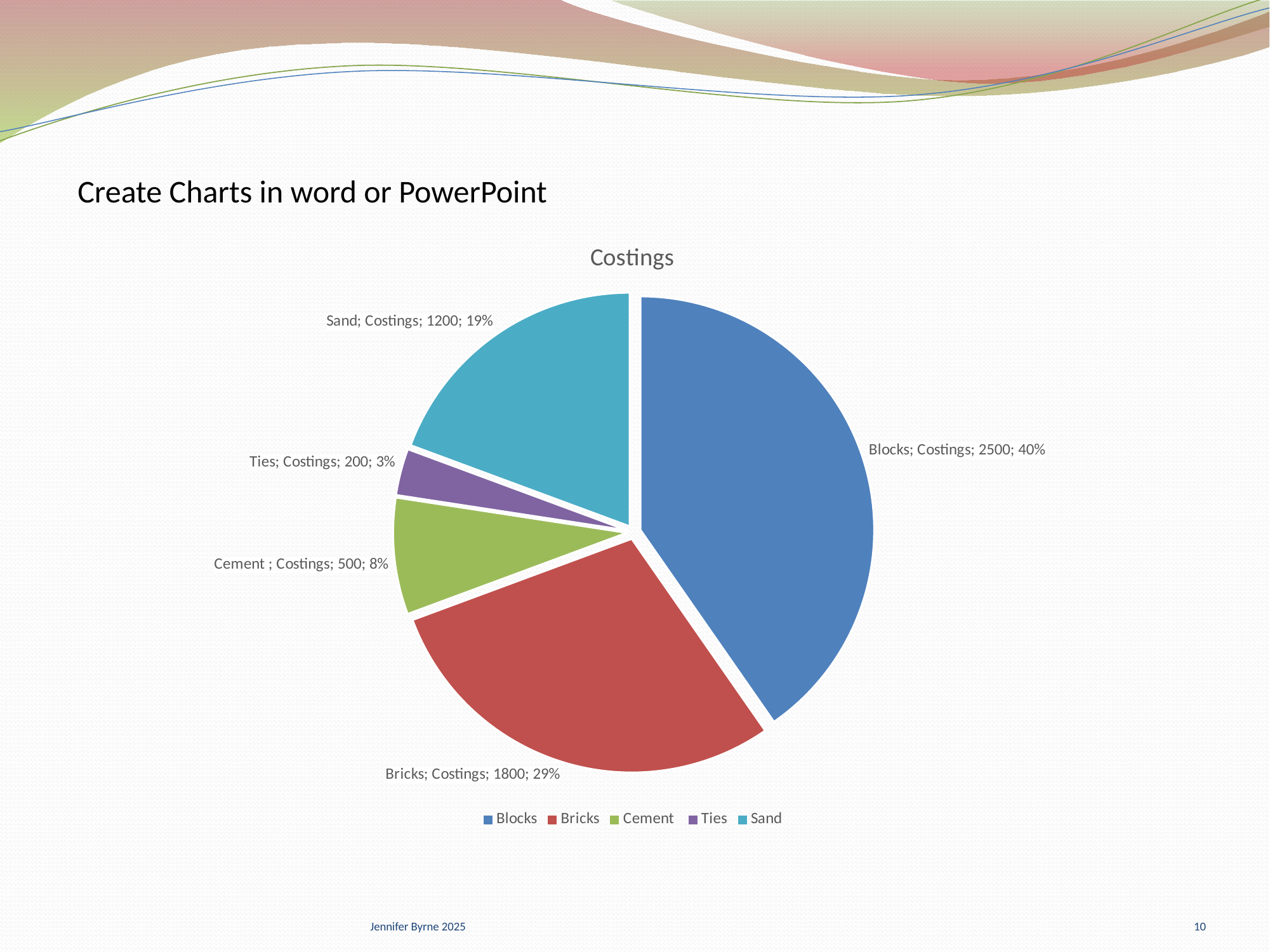
What share of the pie does Cement represent? 8% What type of chart is shown on the slide? pie chart Which category has the smallest slice of the pie? Ties Which has a larger Costings value, Sand or Cement? Sand What is the Costings value for Ties? 200 What is the Costings value for Blocks? 2500 Which category has the largest slice of the pie? Blocks What is the Costings value for Bricks? 1800 What is the difference between the Costings values for Blocks and Bricks? 700 What is the title of the chart? Costings What share of the pie does Sand represent? 19% How many categories are shown in the pie chart? 5